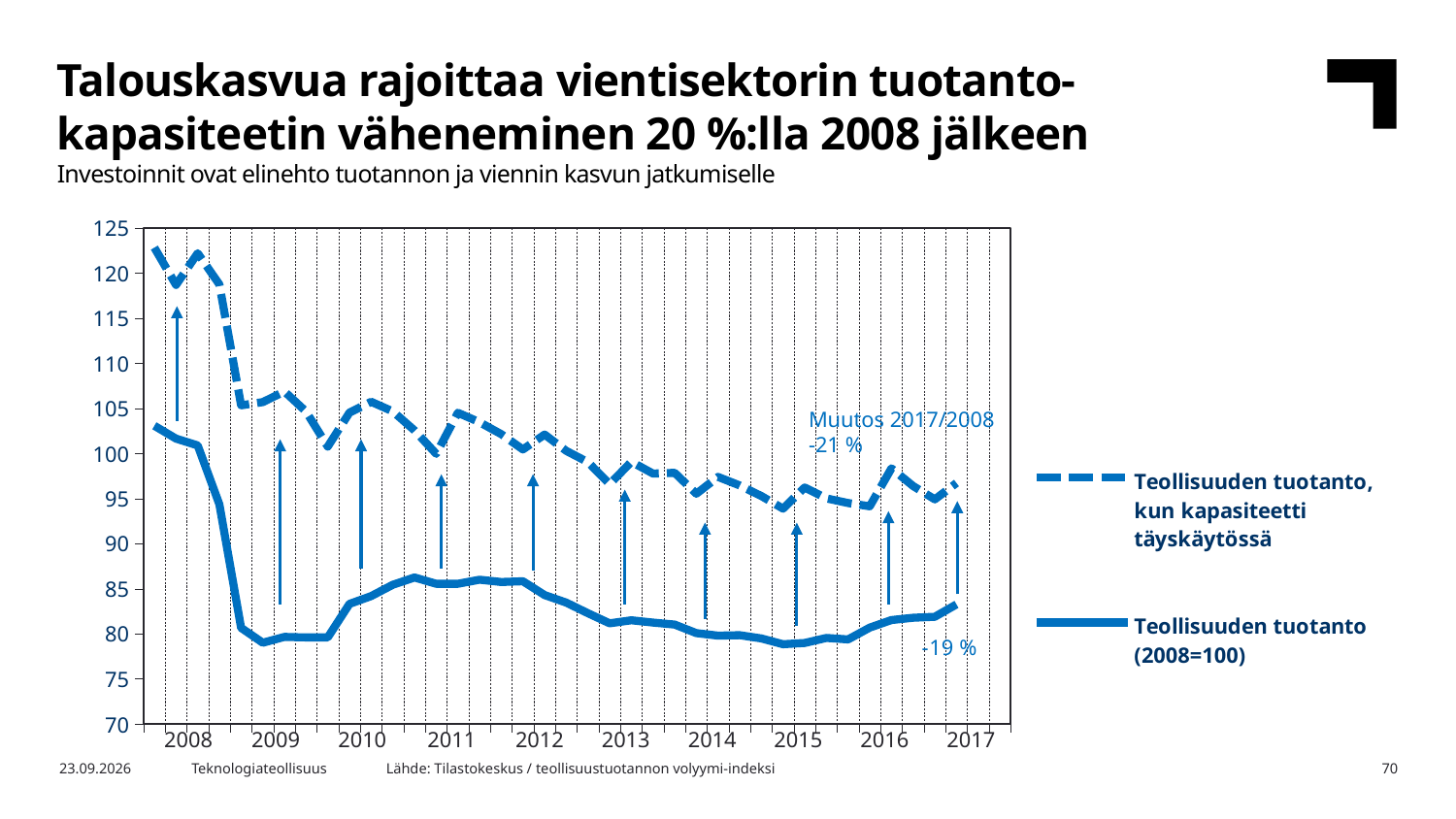
What is the change 2017/2008 shown for the series 'Teollisuuden tuotanto (2008=100)'? -19 % Which series is drawn with a dashed line? Teollisuuden tuotanto, kun kapasiteetti täyskäytössä How many series does the legend list? 2 Is the value of 'Teollisuuden tuotanto (2008=100)' in 2009 greater or less than 85? less Is the value of 'Teollisuuden tuotanto (2008=100)' in 2017 greater or less than 90? less Does 'Teollisuuden tuotanto (2008=100)' rise or fall between 2008 and 2009? fall Which series shows the larger decline between 2008 and 2017, 'Teollisuuden tuotanto, kun kapasiteetti täyskäytössä' or 'Teollisuuden tuotanto (2008=100)'? Teollisuuden tuotanto, kun kapasiteetti täyskäytössä Is the value of 'Teollisuuden tuotanto, kun kapasiteetti täyskäytössä' at the start of 2008 greater or less than 120? greater What is the change 2017/2008 shown for the series 'Teollisuuden tuotanto, kun kapasiteetti täyskäytössä'? -21 % Which series has higher values throughout the chart, the dashed line or the solid line? the dashed line (Teollisuuden tuotanto, kun kapasiteetti täyskäytössä) How many years are labelled on the x axis? 10 What kind of chart is shown on the slide? line chart